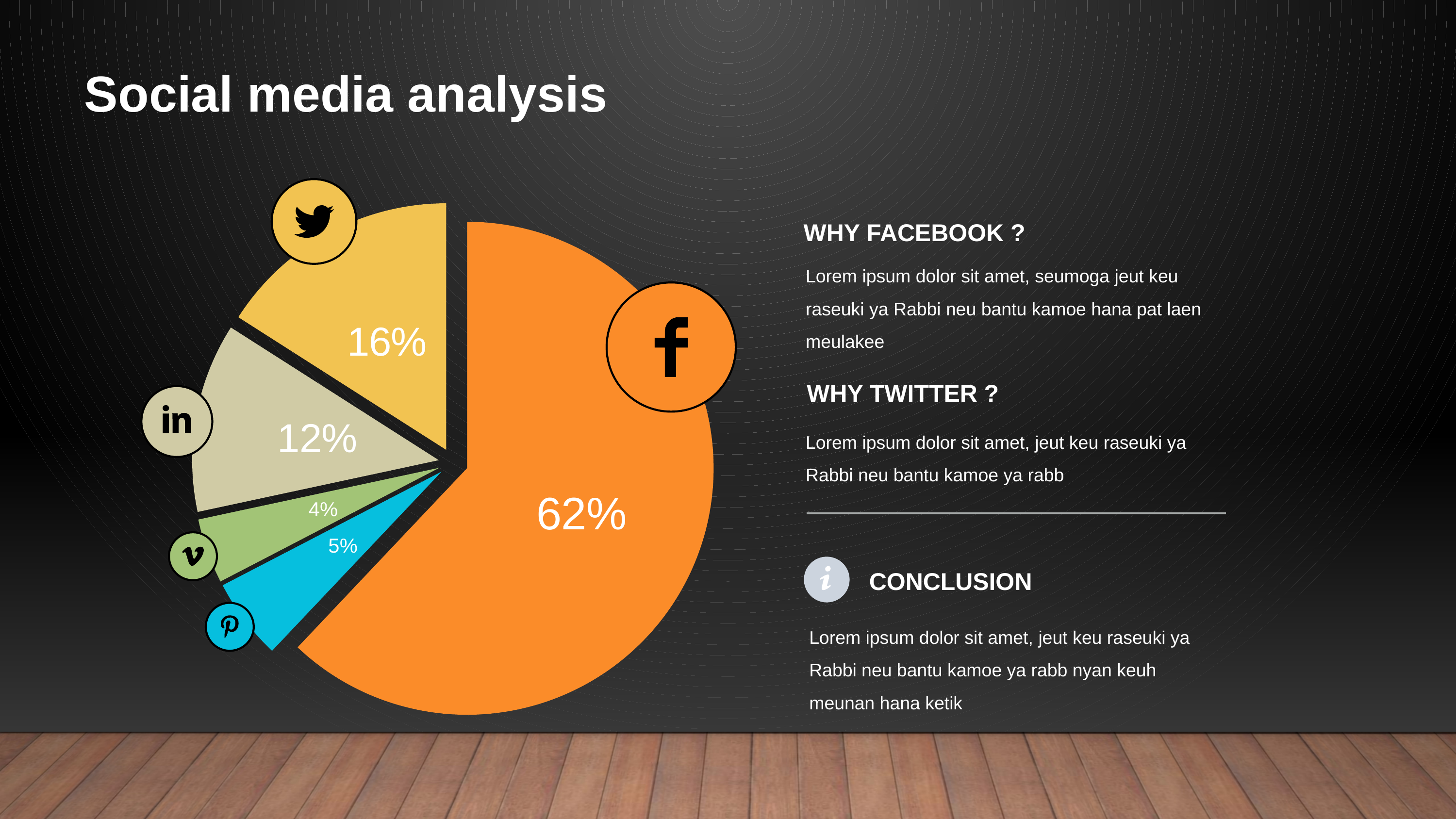
What percentage is shown for the Vimeo (green) slice? 4% By how many percentage points does the Facebook slice exceed the Twitter slice? 46 percentage points What percentage is shown for the LinkedIn (beige) slice? 12% What percentage is shown for the Pinterest (blue) slice? 5% How many slices does the pie chart have? 5 What percentage is shown for the Twitter (yellow) slice? 16% Which social media platform has the smallest slice of the pie chart? Vimeo Which slice is larger, Twitter or LinkedIn? Twitter What is the title of the slide containing the chart? Social media analysis What type of chart is shown on the slide? Pie chart Which social media platform has the largest slice of the pie chart? Facebook What percentage does the Facebook slice of the pie chart show? 62%